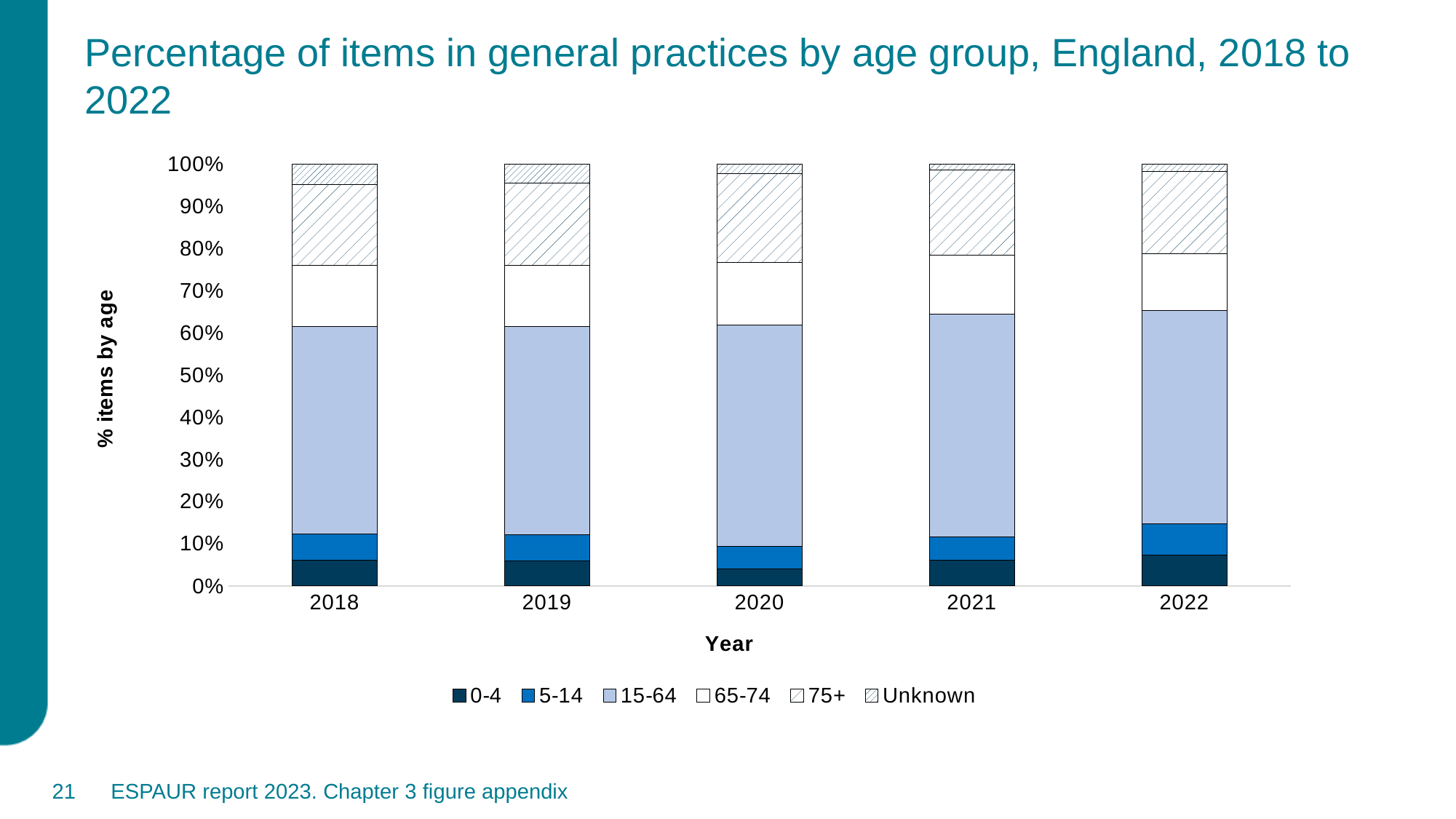
Which age group is listed first in the legend? 0-4 Which year has the larger Unknown segment, 2018 or 2022? 2018 In which year is the 0-4 segment smallest? 2020 Is the combined share of 0-4 and 5-14 in 2022 greater or less than 10%? greater Which year has the larger 0-4 segment, 2020 or 2022? 2022 How many years are shown on the x axis of the chart? 5 Does the cumulative top of the 15-64 segment in 2022 sit above or below 60%? above What kind of chart is shown on the slide? Stacked bar chart What is the title of the y axis? % items by age Does the Unknown segment grow or shrink from 2018 to 2022? Shrinks Is the 0-4 segment for 2020 greater or less than 10%? less How many age-group series does the legend list? 6